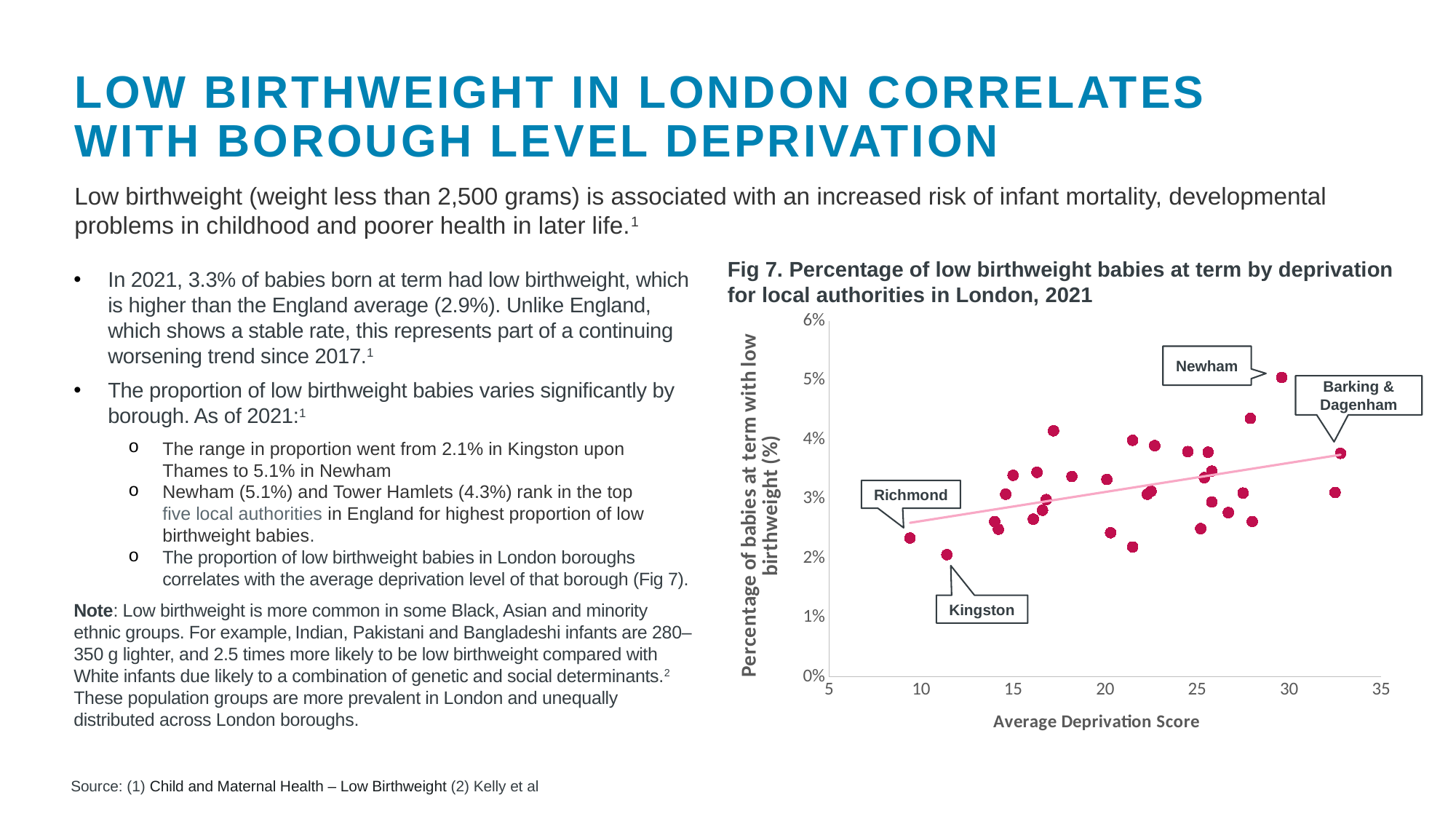
In Fig 7, is the percentage of low birthweight babies for Newham greater or less than 4%? greater In Fig 7, is the percentage of low birthweight babies for Kingston greater or less than 3%? less In Fig 7, which has a higher percentage of low birthweight babies, Newham or Richmond? Newham Which labelled borough in Fig 7 has the highest percentage of low birthweight babies? Newham What kind of chart is Fig 7? scatter chart In Fig 7, is the average deprivation score for Richmond greater or less than 10? less In Fig 7, does the percentage of low birthweight babies tend to rise or fall as the average deprivation score increases? rise What is the highest value shown on the vertical axis of Fig 7? 6% Which labelled borough in Fig 7 has the lowest percentage of low birthweight babies? Kingston What is the label of the horizontal axis in Fig 7? Average Deprivation Score